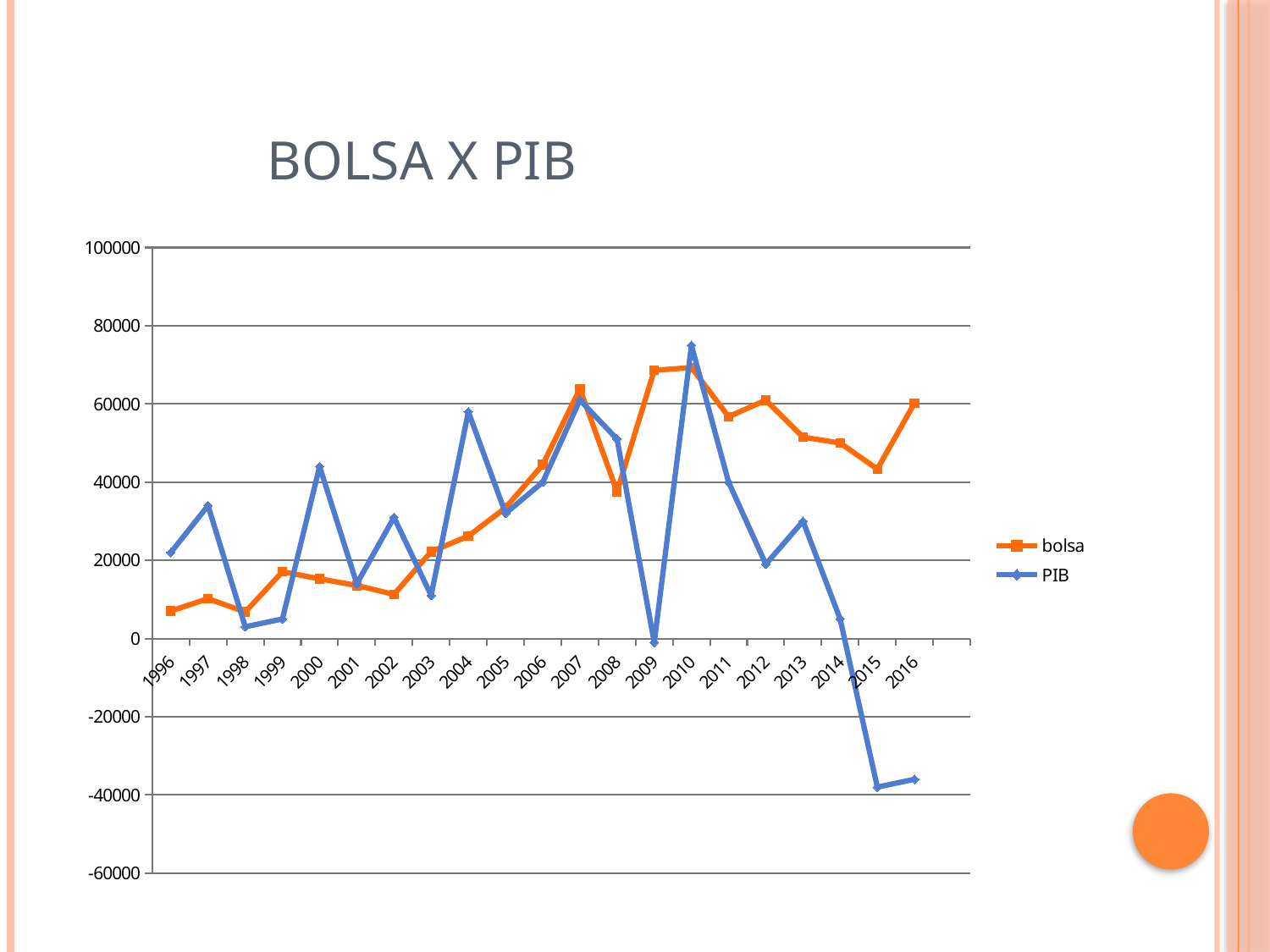
Which series is drawn in orange? bolsa Is the value for bolsa in 2009 greater or less than 60000? greater How many series does the legend list? 2 Is the value for PIB in 2015 greater or less than -20000? less In which year does PIB reach its highest value? 2010 In 2015, which series has the larger value, bolsa or PIB? bolsa Does the PIB series rise or fall from 2013 to 2015? fall Is the value for bolsa in 1996 greater or less than 20000? less How many years are plotted along the x axis? 21 What is the title of the slide containing the chart? BOLSA X PIB What kind of chart is shown on the slide? line chart